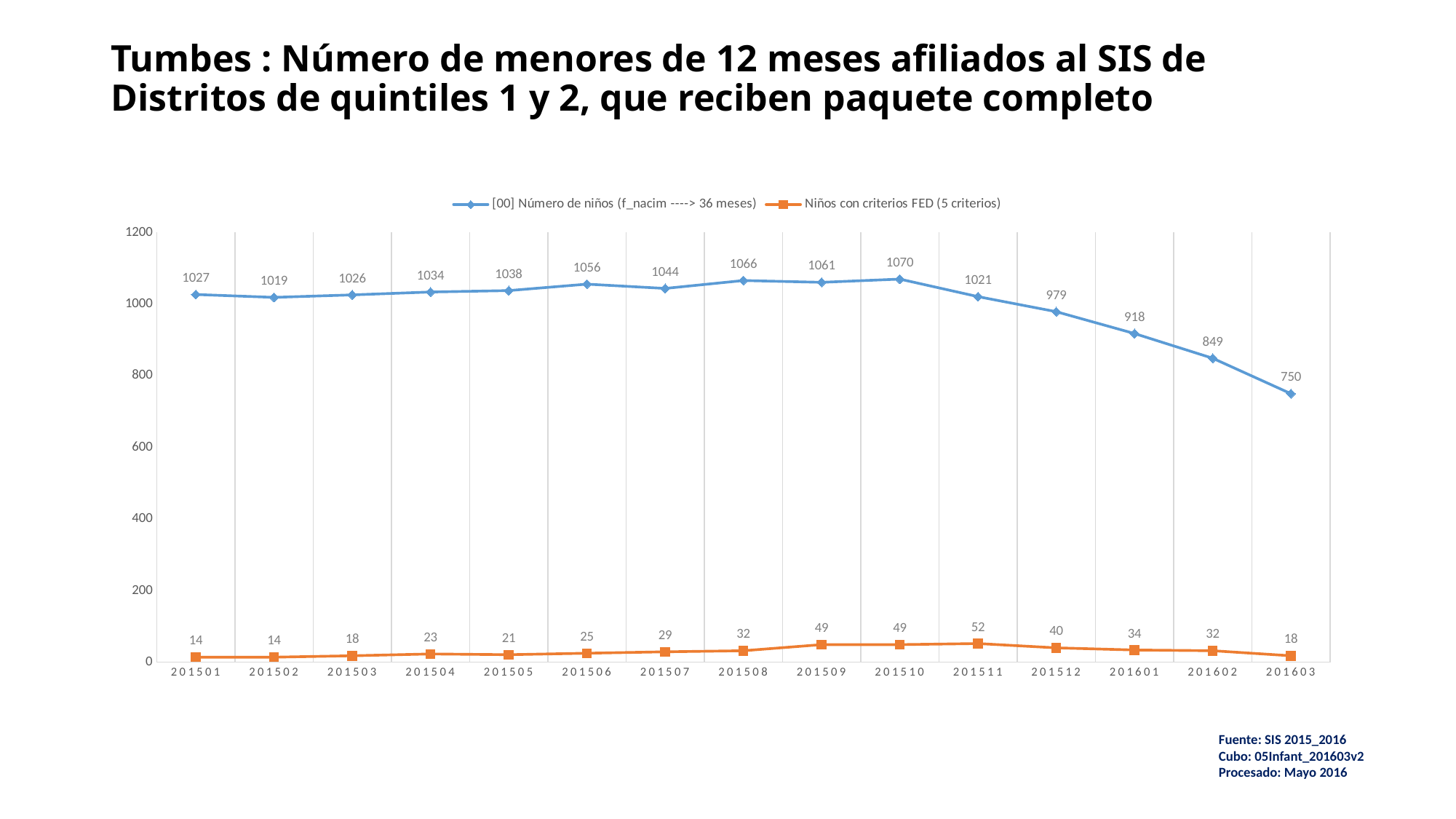
What is the value of the 'Niños con criterios FED (5 criterios)' series for 201511? 52 In which period does the 'Niños con criterios FED (5 criterios)' series reach its highest value? 201511 What is the difference between the '[00] Número de niños' values for 201510 and 201603? 320 Does the '[00] Número de niños' series rise or fall from 201510 to 201603? Fall How many series does the legend list? 2 In which period does the '[00] Número de niños' series reach its lowest value? 201603 What is the value of the '[00] Número de niños' series for 201510? 1070 In which period does the '[00] Número de niños' series reach its highest value? 201510 What is the value of the '[00] Número de niños' series for 201603? 750 Which is larger for the 'Niños con criterios FED (5 criterios)' series: the value for 201509 or the value for 201512? 201509 How many periods are shown on the x axis? 15 What kind of chart is shown on the slide? Line chart